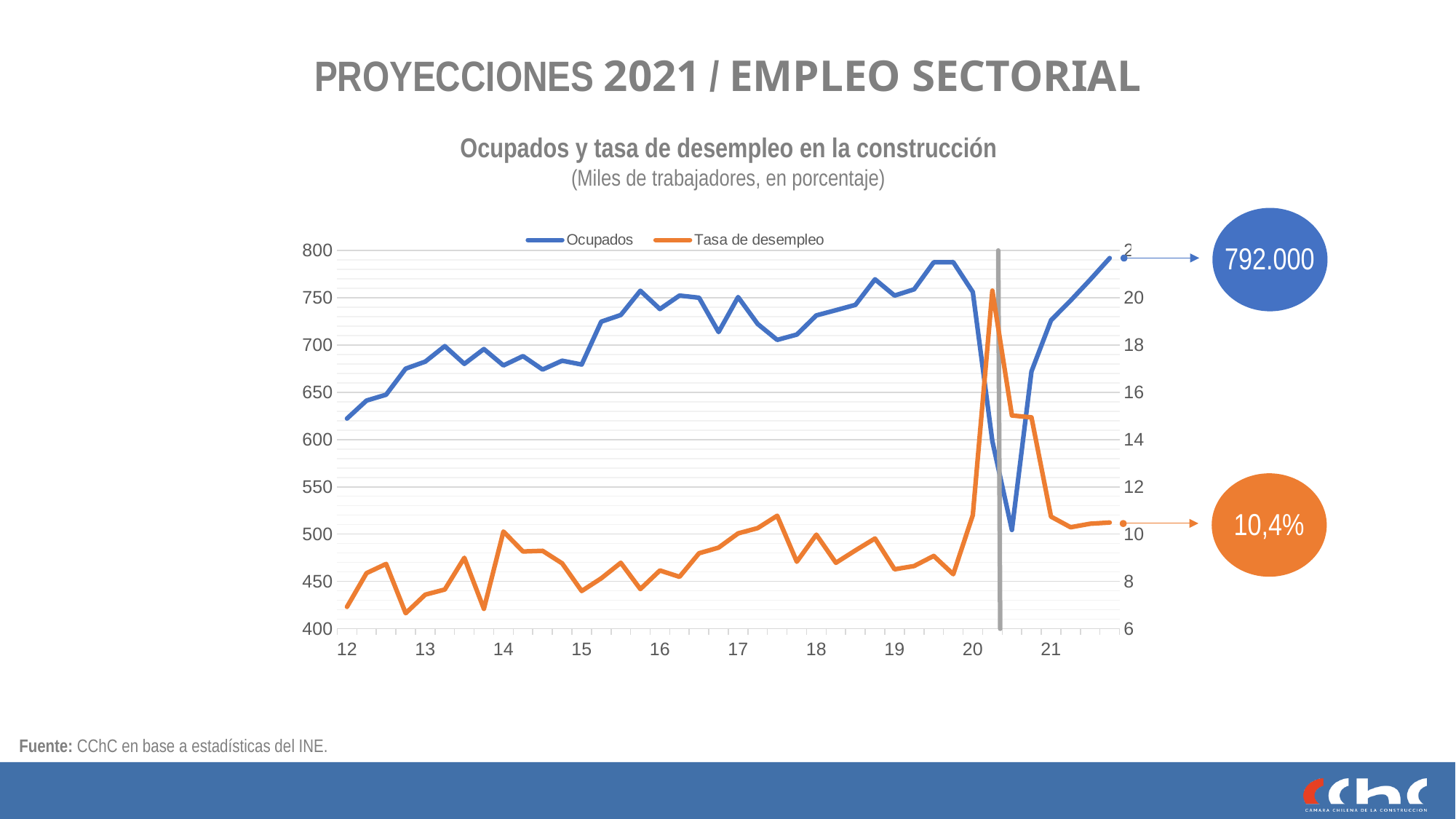
What are the two series named in the chart legend? Ocupados and Tasa de desempleo Does the Ocupados series generally rise or fall between year 12 and year 19? rise How many series does the chart legend list? 2 What kind of chart is shown on the slide? line chart What is the title of the chart? Ocupados y tasa de desempleo en la construcción Is the peak value of Tasa de desempleo in 2020 greater or less than 18? greater What is the final value of the Tasa de desempleo series, as shown in the orange callout? 10,4% Is the value of Ocupados at the start of the series (year 12) greater or less than 650? less What is the final value of the Ocupados series, as shown in the blue callout? 792.000 In which year does the Tasa de desempleo series reach its highest point? 20 Is the lowest value of Ocupados during 2020 greater or less than 550? less